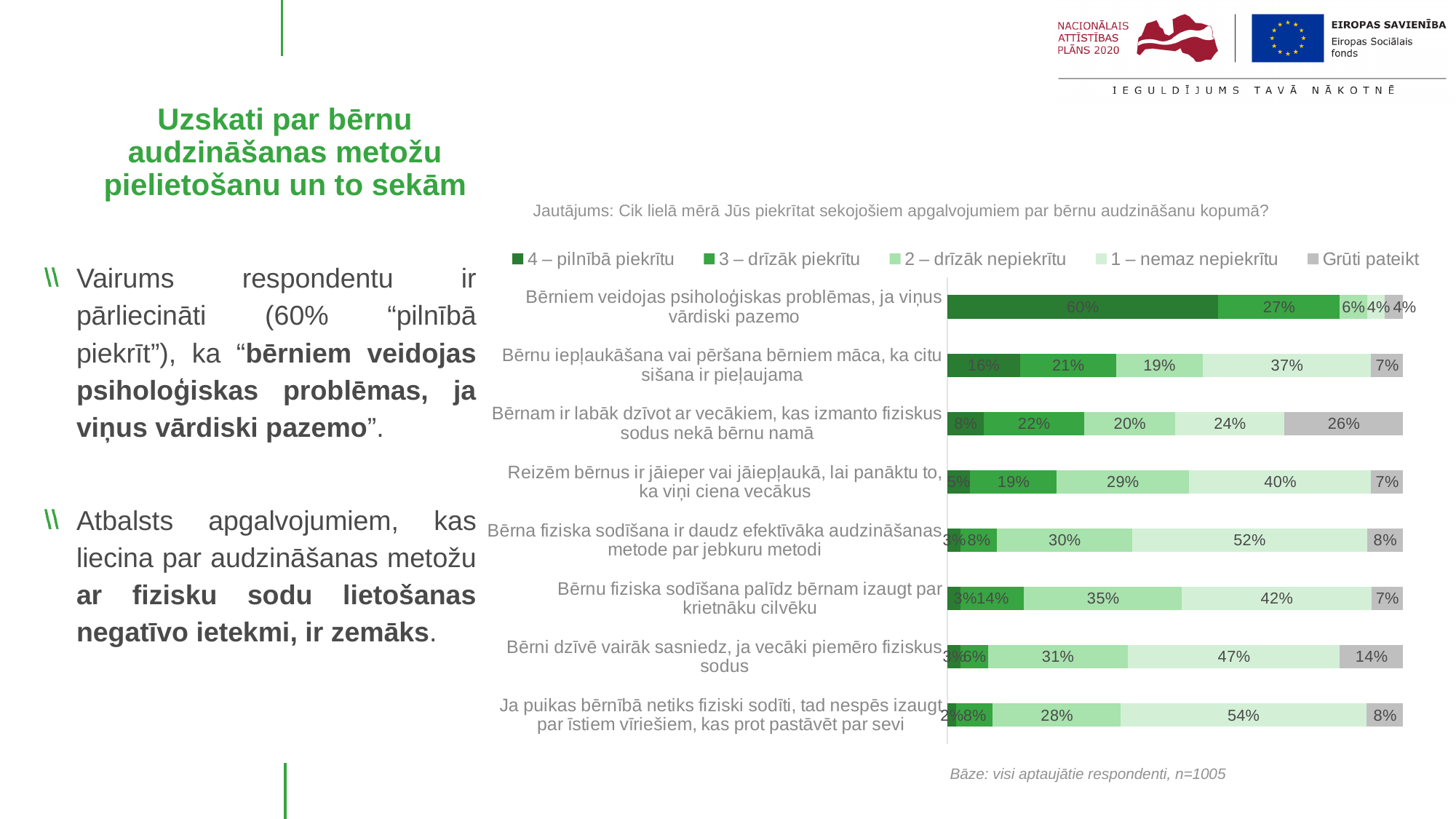
Which statement has the highest "Grūti pateikt" share? Bērnam ir labāk dzīvot ar vecākiem, kas izmanto fiziskus sodus nekā bērnu namā Which is larger: the "3 – drīzāk piekrītu" value for "Bērnu iepļaukāšana vai pēršana bērniem māca, ka citu sišana ir pieļaujama" or for "Reizēm bērnus ir jāieper vai jāiepļaukā, lai panāktu to, ka viņi ciena vecākus"? Bērnu iepļaukāšana vai pēršana bērniem māca, ka citu sišana ir pieļaujama (21%) What is the difference between the "1 – nemaz nepiekrītu" values for "Bērna fiziska sodīšana ir daudz efektīvāka audzināšanas metode par jebkuru metodi" (52%) and "Bērnu fiziska sodīšana palīdz bērnam izaugt par krietnāku cilvēku" (42%)? 10% Which statement has the lowest "1 – nemaz nepiekrītu" share? Bērniem veidojas psiholoģiskas problēmas, ja viņus vārdiski pazemo How many series does the legend list? 5 What kind of chart is shown on the slide? Stacked bar chart How many statements (categories) are plotted in the chart? 8 What is the "Grūti pateikt" value for the statement "Bērnam ir labāk dzīvot ar vecākiem, kas izmanto fiziskus sodus nekā bērnu namā"? 26% What share of respondents answered "4 – pilnībā piekrītu" to the statement "Bērniem veidojas psiholoģiskas problēmas, ja viņus vārdiski pazemo"? 60% What is the "1 – nemaz nepiekrītu" value for the statement "Ja puikas bērnībā netiks fiziski sodīti, tad nespēs izaugt par īstiem vīriešiem, kas prot pastāvēt par sevi"? 54% What is the base (sample size) stated below the chart? n=1005 Which statement has the highest "4 – pilnībā piekrītu" share? Bērniem veidojas psiholoģiskas problēmas, ja viņus vārdiski pazemo